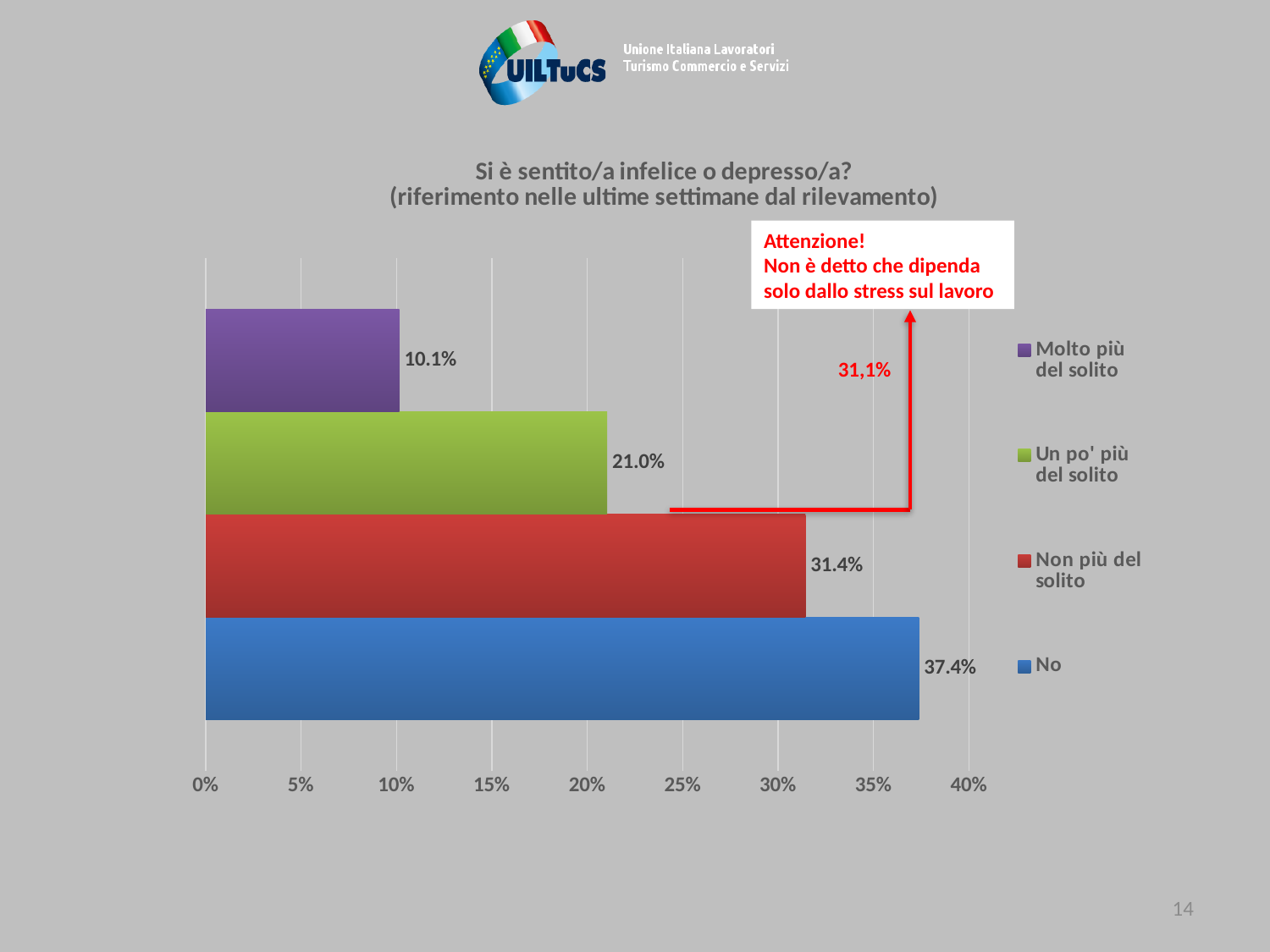
How many entries does the legend list? 4 What is the value for "Un po' più del solito"? 21.0% What is the value for "Non più del solito"? 31.4% Which category has the lowest value? Molto più del solito How many categories are shown in the chart? 4 What is the value for "Molto più del solito"? 10.1% What is the value for "No"? 37.4% What kind of chart is shown on the slide? Bar chart Which category has the highest value? No What percentage is written in red next to the annotation arrow on the chart? 31,1% What is the difference between the values for "No" and "Non più del solito"? 6.0% Which is larger, the value for "Un po' più del solito" or the value for "Molto più del solito"? Un po' più del solito